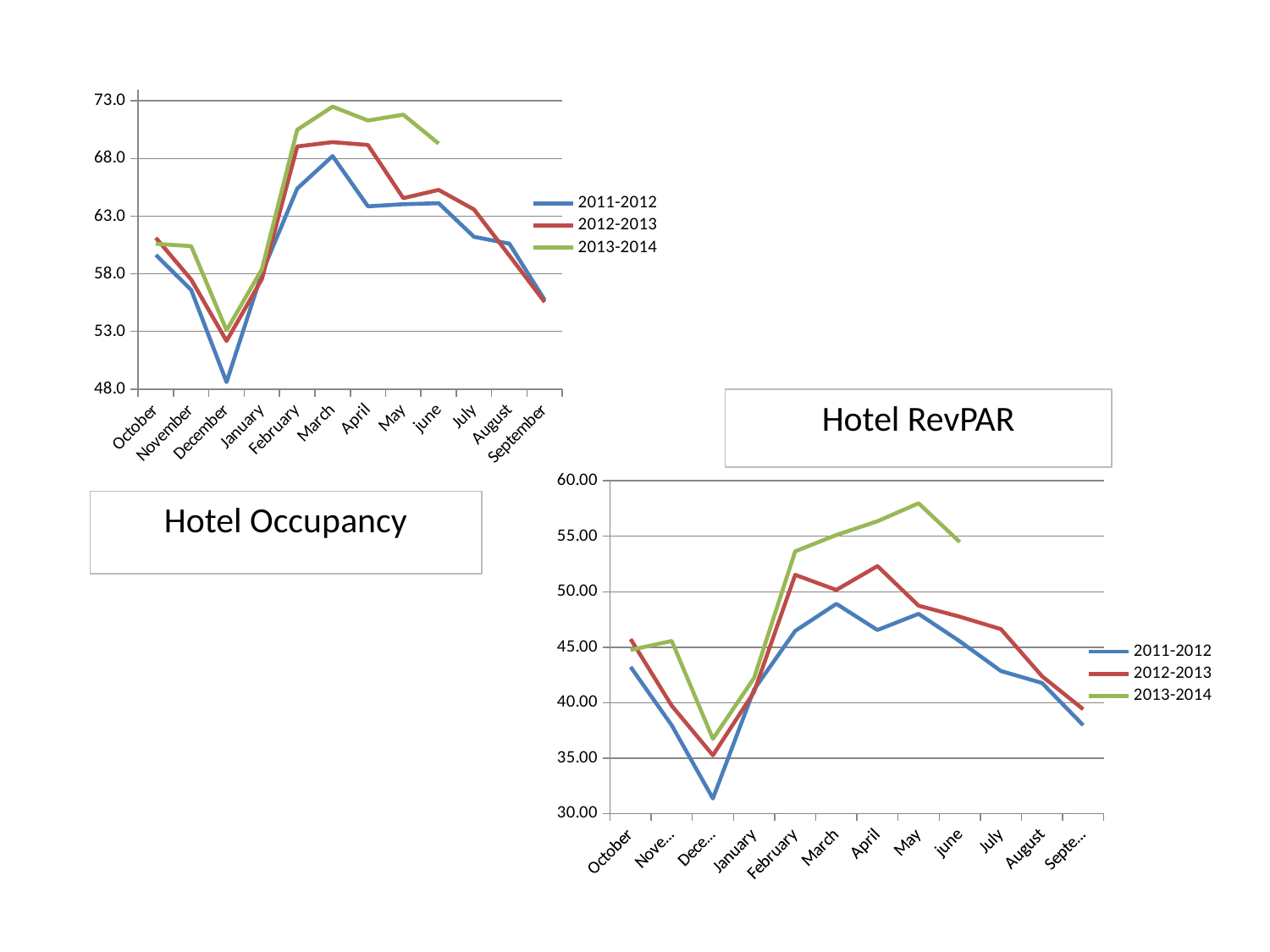
In the Hotel RevPAR chart, which month has the highest value for the 2013-2014 series? May How many series does the legend of the Hotel RevPAR chart list? 3 In the Hotel Occupancy chart, does the 2011-2012 series rise or fall from March to September? fall What kind of chart is the Hotel Occupancy chart? line chart In the Hotel RevPAR chart, is the May value for 2013-2014 greater or less than 55.00? greater In the Hotel RevPAR chart, is the December value for 2011-2012 greater or less than 35.00? less In the Hotel Occupancy chart, is the March value for 2013-2014 greater or less than 68.0? greater How many months are shown on the x axis of the Hotel Occupancy chart? 12 In the Hotel RevPAR chart, which series has the larger value in March, 2011-2012 or 2013-2014? 2013-2014 In the Hotel Occupancy chart, which month has the highest value for the 2013-2014 series? March In the Hotel Occupancy chart, which month has the lowest value for the 2011-2012 series? December